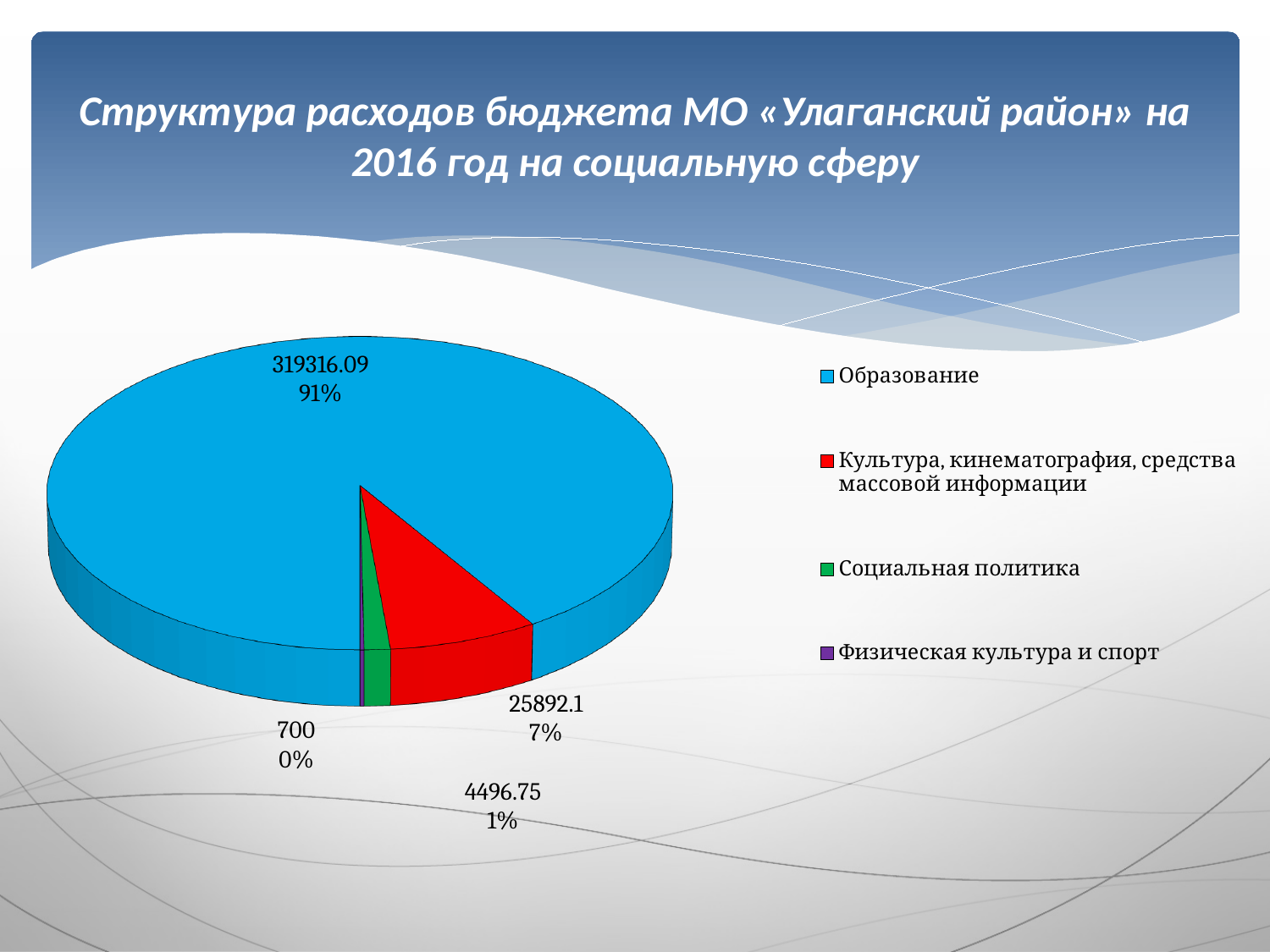
Which is larger, Социальная политика or Физическая культура и спорт? Социальная политика What kind of chart is shown on the slide? pie chart How many categories does the pie chart have? 4 Which category has the smallest slice? Физическая культура и спорт Which category has the largest slice? Образование What is the value for Культура, кинематография, средства массовой информации? 25892.1 What is the value for Социальная политика? 4496.75 What is the value for Образование? 319316.09 What colour is the slice for Социальная политика? green What is the value for Физическая культура и спорт? 700 What share of the pie does Культура, кинематография, средства массовой информации take? 7% What share of the pie does Образование take? 91%